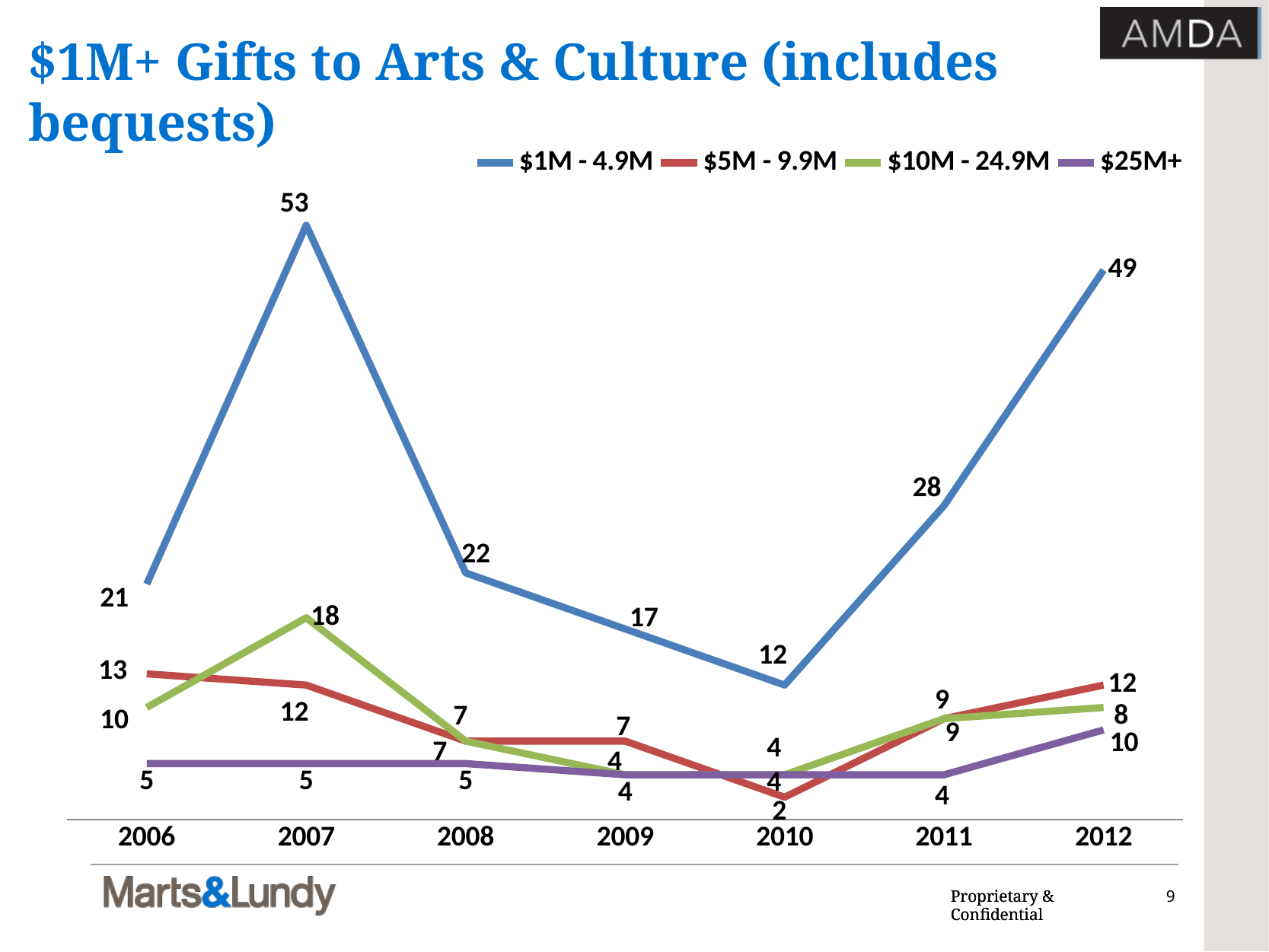
Which is larger in 2012: the $5M - 9.9M value or the $10M - 24.9M value? $5M - 9.9M How many series does the legend list? 4 What is the value for the $25M+ series in 2012? 8 What type of chart is shown on the slide? line chart What is the value for the $1M - 4.9M series in 2007? 53 Does the $1M - 4.9M series rise or fall from 2010 to 2012? rise In which year is the $1M - 4.9M series at its highest? 2007 What is the difference between the $1M - 4.9M values in 2007 and 2008? 31 What is the value for the $5M - 9.9M series in 2010? 2 What is the value for the $10M - 24.9M series in 2007? 18 How many years are shown on the x axis? 7 In which year is the $1M - 4.9M series at its lowest? 2010